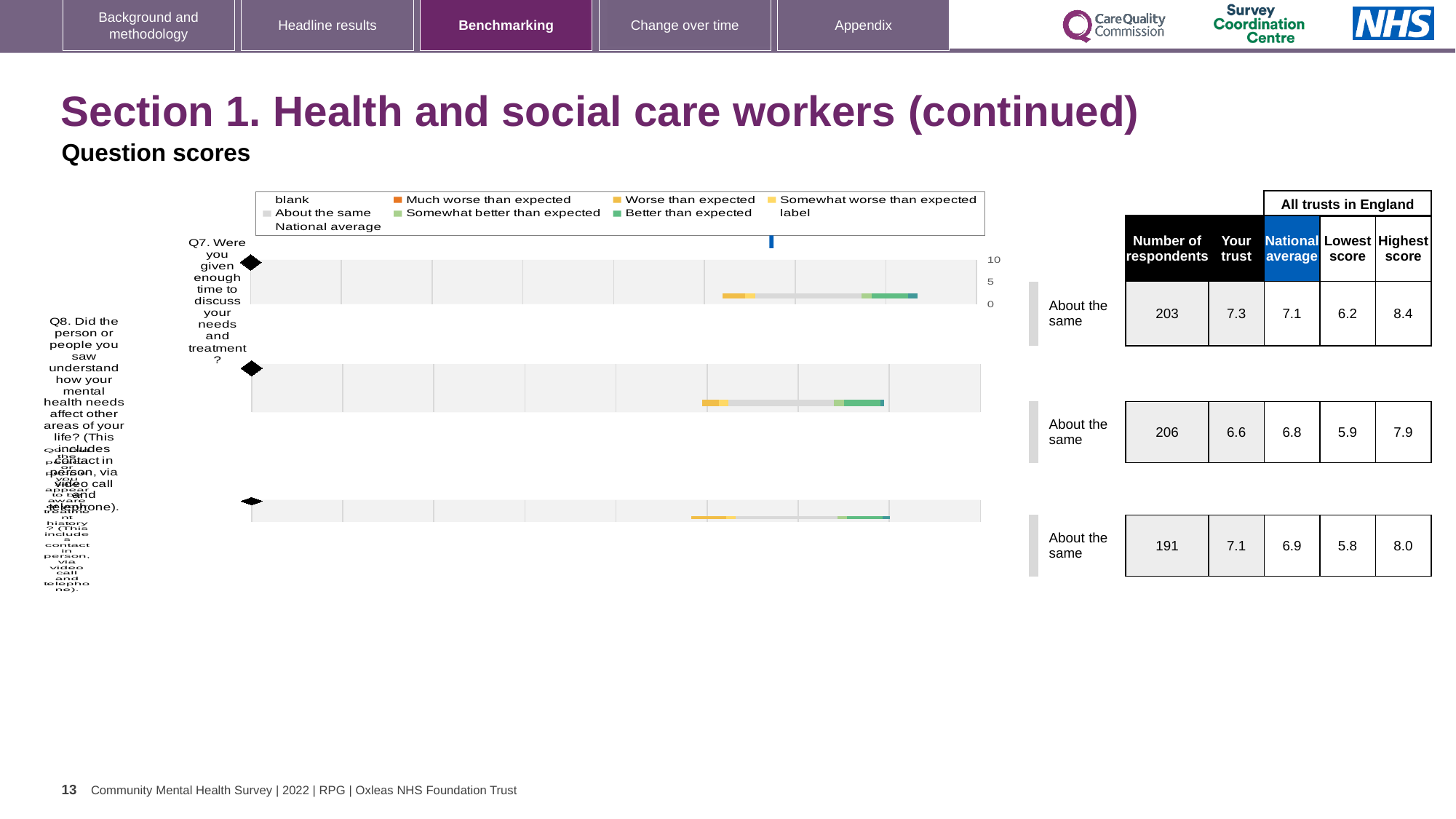
For Q7, what is the difference between the 'Your trust' score and the national average? 0.2 In the table, what is the highest score across all trusts in England for Q7? 8.4 In the table, what is the national average for Q8 (Did the person or people you saw understand how your mental health needs affect other areas of your life?)? 6.8 Which row has the lowest number of respondents in the table? the third (bottom) row For Q8, which is larger: the 'Your trust' score or the national average? National average In the table, what is the 'Your trust' score for Q7 (Were you given enough time to discuss your needs and treatment?)? 7.3 In the table, how many respondents are listed for the third question (bottom row)? 191 How many question charts are shown on the slide? 3 What kind of chart is used to show the question scores on this slide? bar chart In the legend, what colour represents 'Much worse than expected'? orange Which question has the highest 'Your trust' score in the table? Q7 What benchmark category is shown next to each of the three charts? About the same